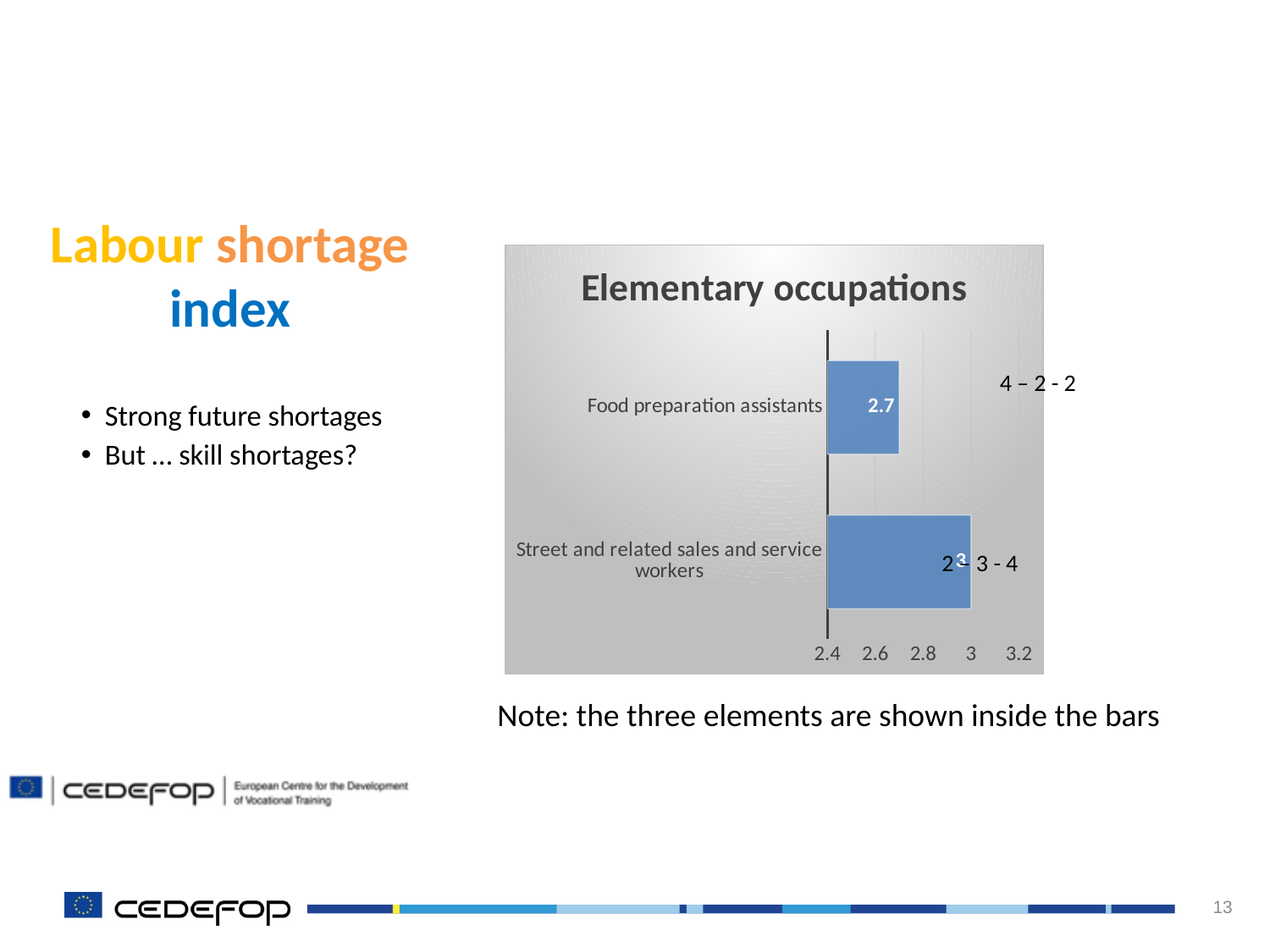
What type of chart is shown on the slide? bar chart Is the value for Street and related sales and service workers greater or less than 2.8? greater What is the value for Street and related sales and service workers? 3 How many occupation categories are plotted in the chart? 2 What is the difference between the values for Street and related sales and service workers and Food preparation assistants? 0.3 What is the value for Food preparation assistants? 2.7 What is the highest tick value shown on the horizontal axis? 3.2 Which category has the highest value? Street and related sales and service workers What is the title of the chart? Elementary occupations Is the value for Food preparation assistants greater or less than 2.8? less Which category has the lowest value? Food preparation assistants Which is larger: the value for Food preparation assistants or for Street and related sales and service workers? Street and related sales and service workers